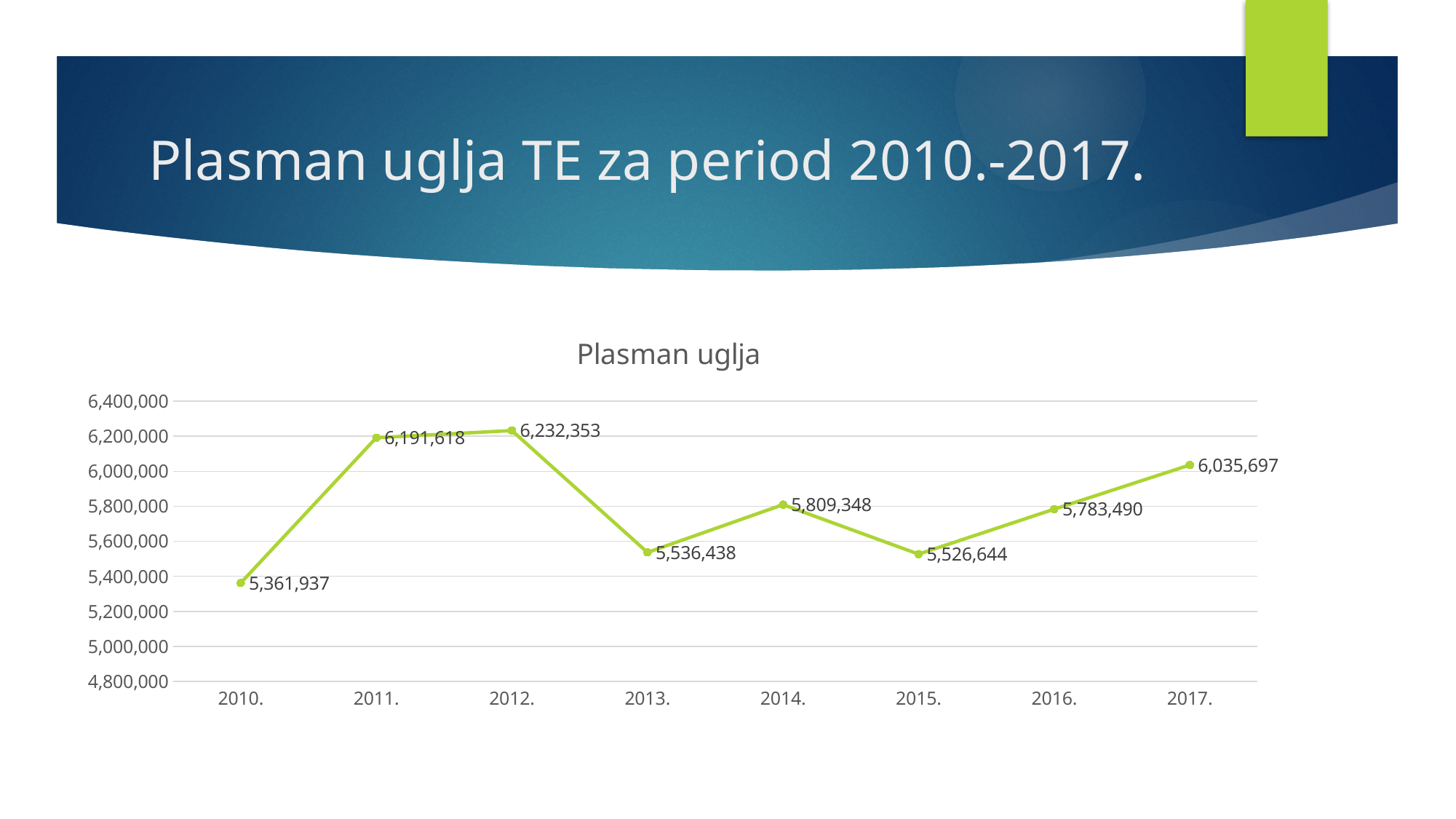
Which year has the highest value in the Plasman uglja chart? 2012. What is the value for 2017. in the Plasman uglja chart? 6,035,697 Is the value for 2013. greater or less than 5,600,000? less What is the value for 2014. in the Plasman uglja chart? 5,809,348 What is the difference between the values for 2017. and 2016.? 252,207 How many years are plotted in the Plasman uglja chart? 8 Does the value rise or fall from 2012. to 2013.? fall Which is larger, the value for 2014. or the value for 2016.? 2014. What kind of chart is shown on the slide? line chart Which year has the lowest value in the Plasman uglja chart? 2010. What is the difference between the values for 2012. and 2011.? 40,735 What is the value for 2010. in the Plasman uglja chart? 5,361,937